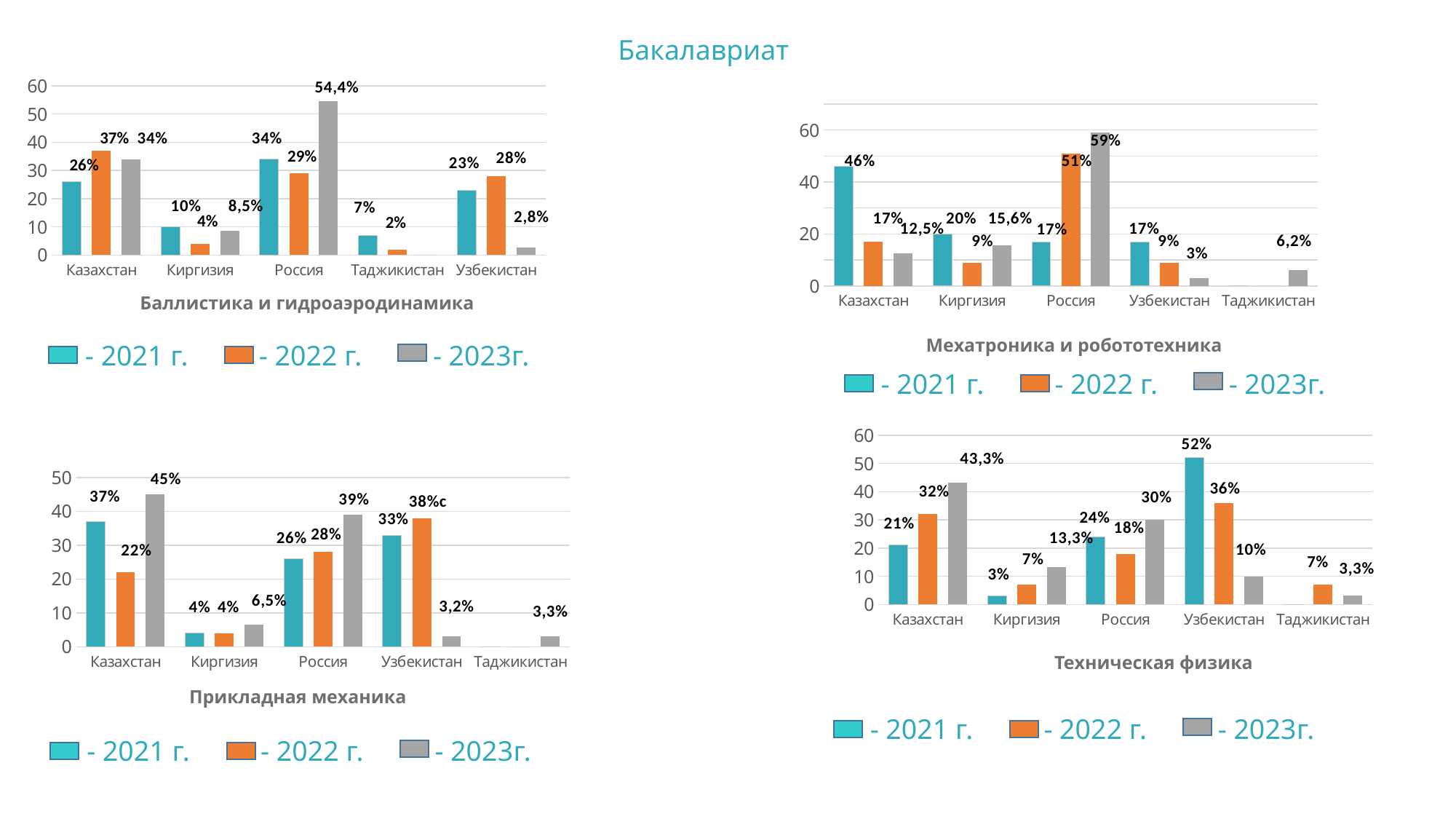
In the chart titled "Техническая физика", is the 2022 value for Казахстан larger or the 2022 value for Россия? Казахстан In the chart titled "Мехатроника и робототехника", what is the difference between the 2023 values for Россия and Казахстан? 46,5% In the chart titled "Техническая физика", which country has the highest value in 2021? Узбекистан In the chart titled "Мехатроника и робототехника", what is the value for Россия in 2022? 51% How many series does the legend list for the chart titled "Прикладная механика"? 3 In the chart titled "Баллистика и гидроаэродинамика", what is the value for Россия in 2023? 54,4% In the chart titled "Баллистика и гидроаэродинамика", what is the value for Узбекистан in 2021? 23% In the chart titled "Техническая физика", what is the difference between the 2021 and 2023 values for Узбекистан? 42% In the chart titled "Прикладная механика", what is the value for Казахстан in 2023? 45% In the chart titled "Мехатроника и робототехника", which country has the highest value in 2021? Казахстан What kind of chart is the chart titled "Техническая физика"? Bar chart